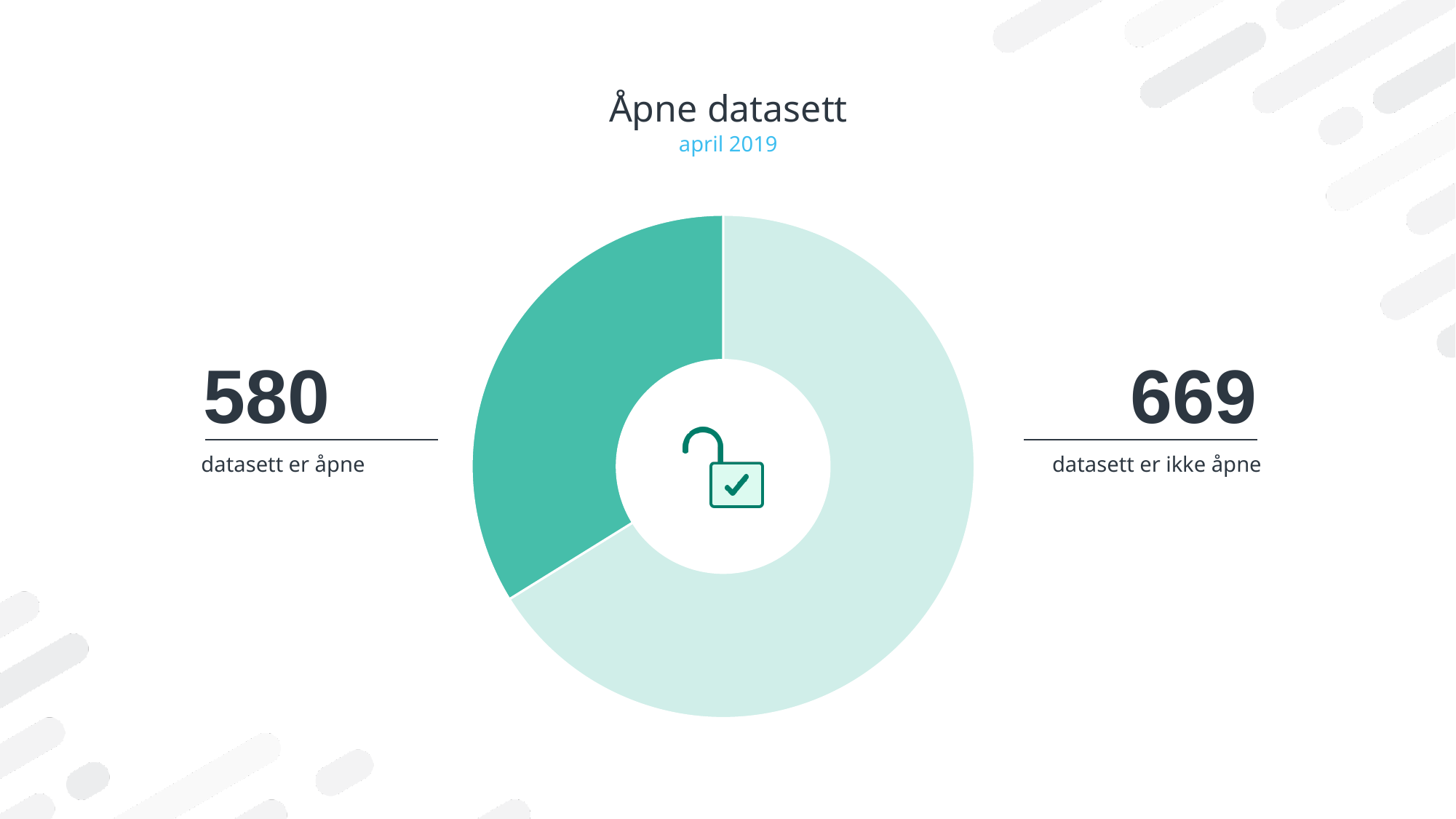
Which category has the smaller value in the chart? datasett er åpne Which month and year does the chart refer to? april 2019 How many datasets are not open (datasett er ikke åpne) according to the chart? 669 What kind of chart is shown on the slide? Pie chart (donut) How many datasets are open (datasett er åpne) according to the chart? 580 Which category has the larger value, open datasets or not-open datasets? datasett er ikke åpne What is the title of the chart? Åpne datasett What is the difference between the number of not-open datasets and the number of open datasets? 89 Is the value for open datasets larger or smaller than the value for not-open datasets? smaller How many segments does the chart have? 2 What is the total number of datasets represented in the chart? 1249